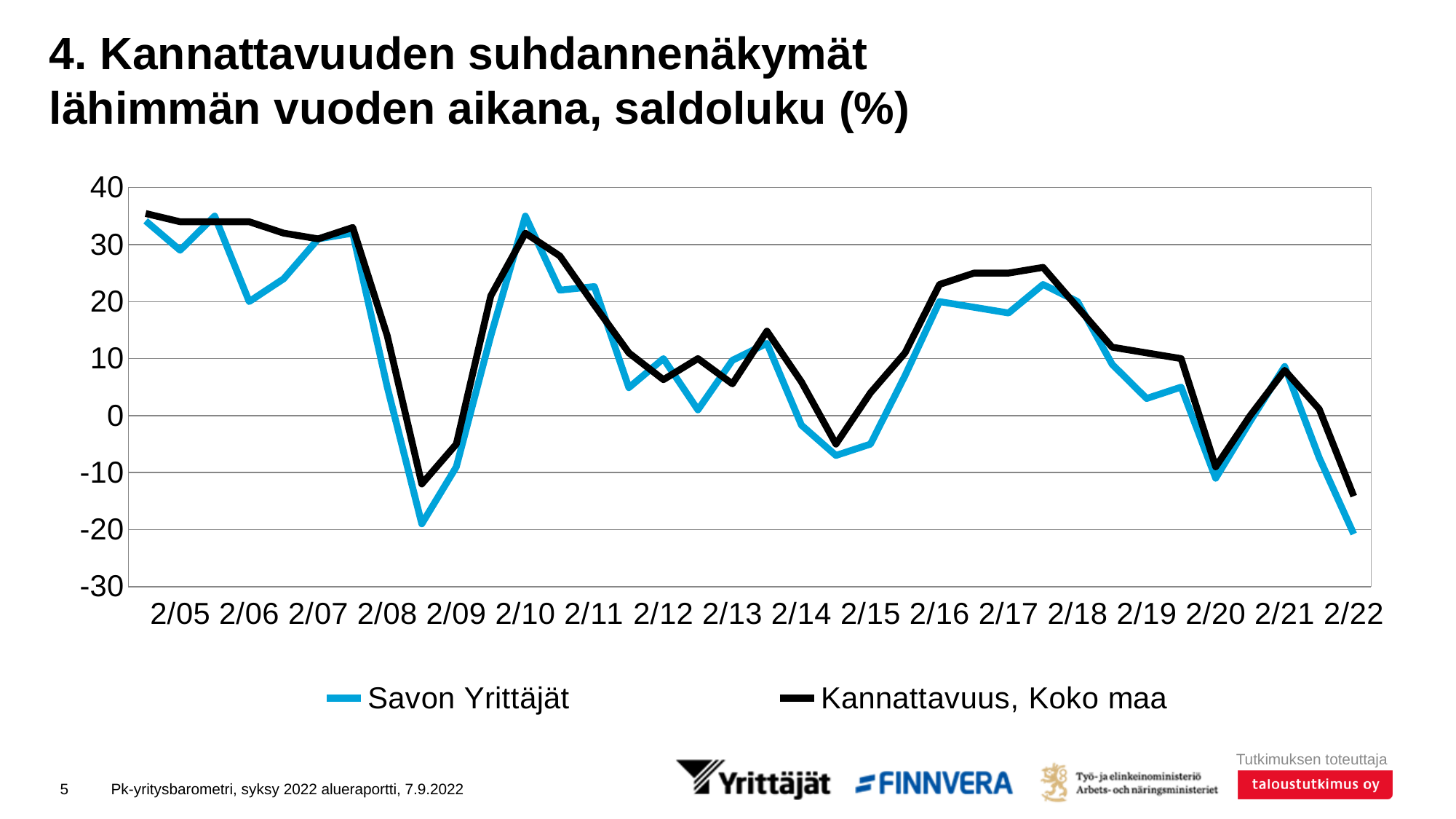
What kind of chart is shown on the slide? line chart How many series does the legend list? 2 At 2/06, which series has the higher value, Savon Yrittäjät or Kannattavuus, Koko maa? Kannattavuus, Koko maa Is the value for Savon Yrittäjät at 2/15 greater or less than 0? less Is the value for Kannattavuus, Koko maa at 2/22 greater or less than -10? less Is the value for Savon Yrittäjät at 2/10 greater or less than 30? greater How many year labels are shown on the x axis? 18 Does the Savon Yrittäjät line rise or fall overall from 2/18 to 2/22? fall At 2/22, which series has the higher value, Savon Yrittäjät or Kannattavuus, Koko maa? Kannattavuus, Koko maa